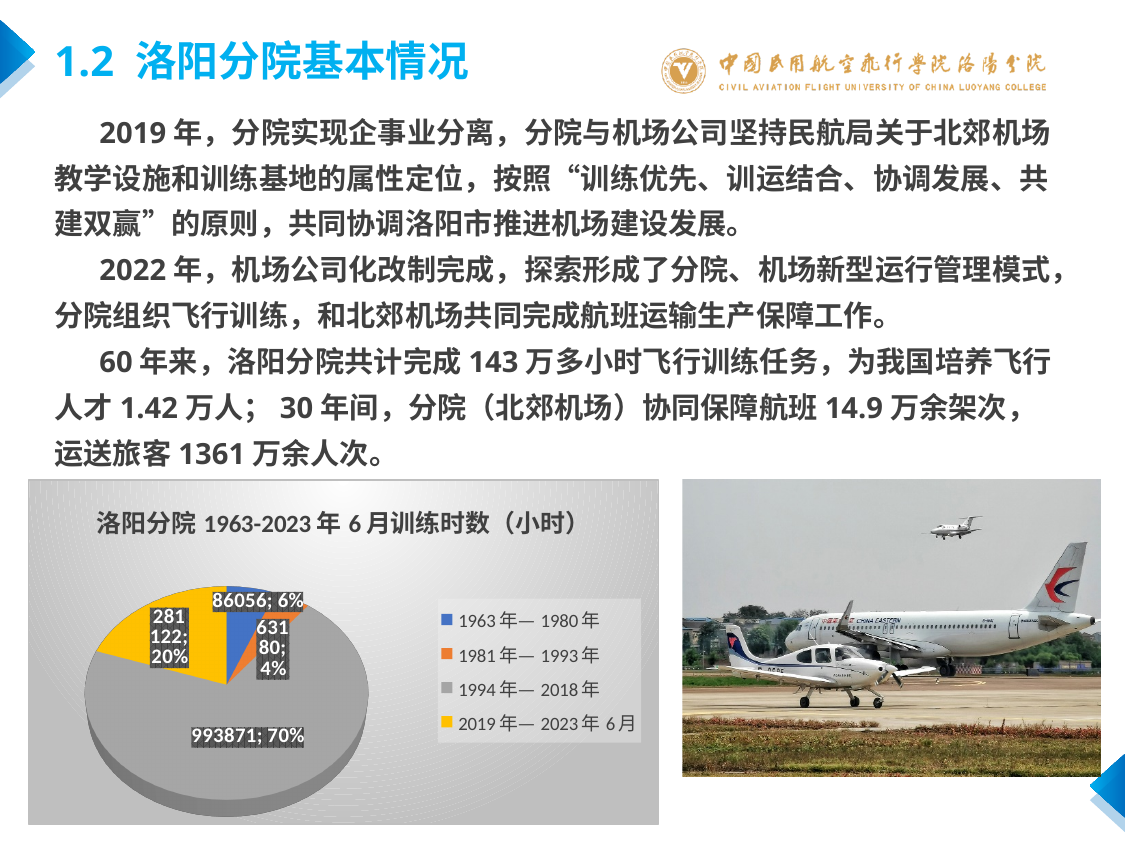
What is the training hours value for 2019年—2023年6月 in the pie chart? 281122 Which is larger in the pie chart: the value for 1963年—1980年 or the value for 2019年—2023年6月? 2019年—2023年6月 What share of the pie does 1994年—2018年 represent? 70% How many categories does the legend of the pie chart list? 4 What is the training hours value for 1994年—2018年 in the pie chart? 993871 What kind of chart is shown on the slide? pie chart What is the training hours value for 1963年—1980年 in the pie chart? 86056 What is the title of the pie chart? 洛阳分院 1963-2023 年 6 月训练时数（小时） What share of the pie does 1981年—1993年 represent? 4% Which period has the smallest slice in the pie chart? 1981年—1993年 Which period has the largest slice in the pie chart? 1994年—2018年 What is the difference between the values for 1994年—2018年 and 2019年—2023年6月 in the pie chart? 712749